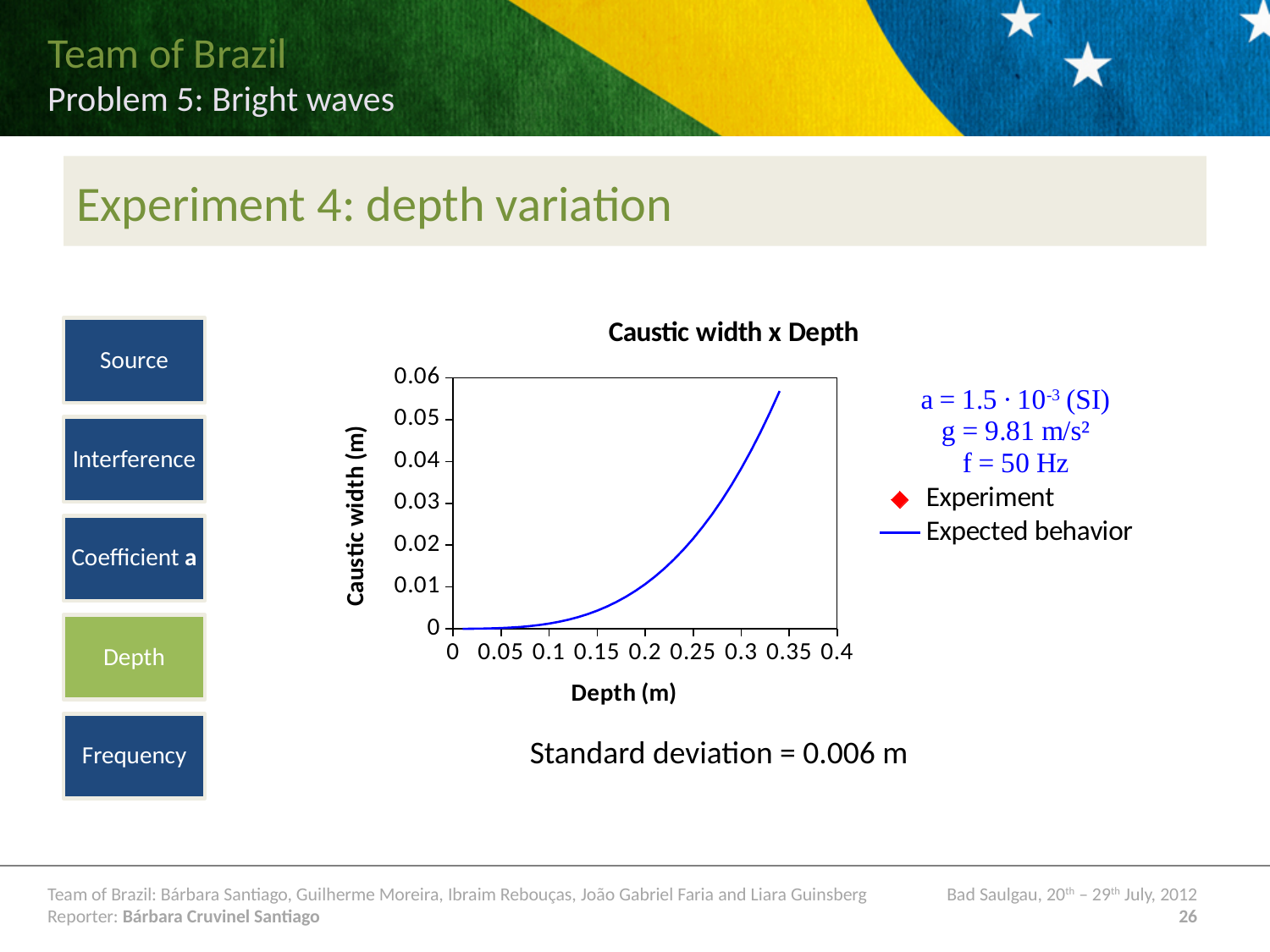
Is the Expected behavior value at a depth of 0.1 m greater or less than 0.01? less What kind of chart is shown on the slide? line chart What is the maximum value shown on the chart's x axis? 0.4 What is the maximum value shown on the chart's y axis? 0.06 Does the Expected behavior curve rise or fall as depth increases along the x axis? rise Is the Expected behavior value at a depth of 0.2 m greater or less than 0.02? less How many series does the chart's legend list? 2 What is the title of the chart? Caustic width x Depth Which has a larger Expected behavior caustic width: a depth of 0.2 m or a depth of 0.3 m? 0.3 m What are the two series named in the chart's legend? Experiment and Expected behavior Is the Expected behavior value at a depth of 0.3 m greater or less than 0.03? greater